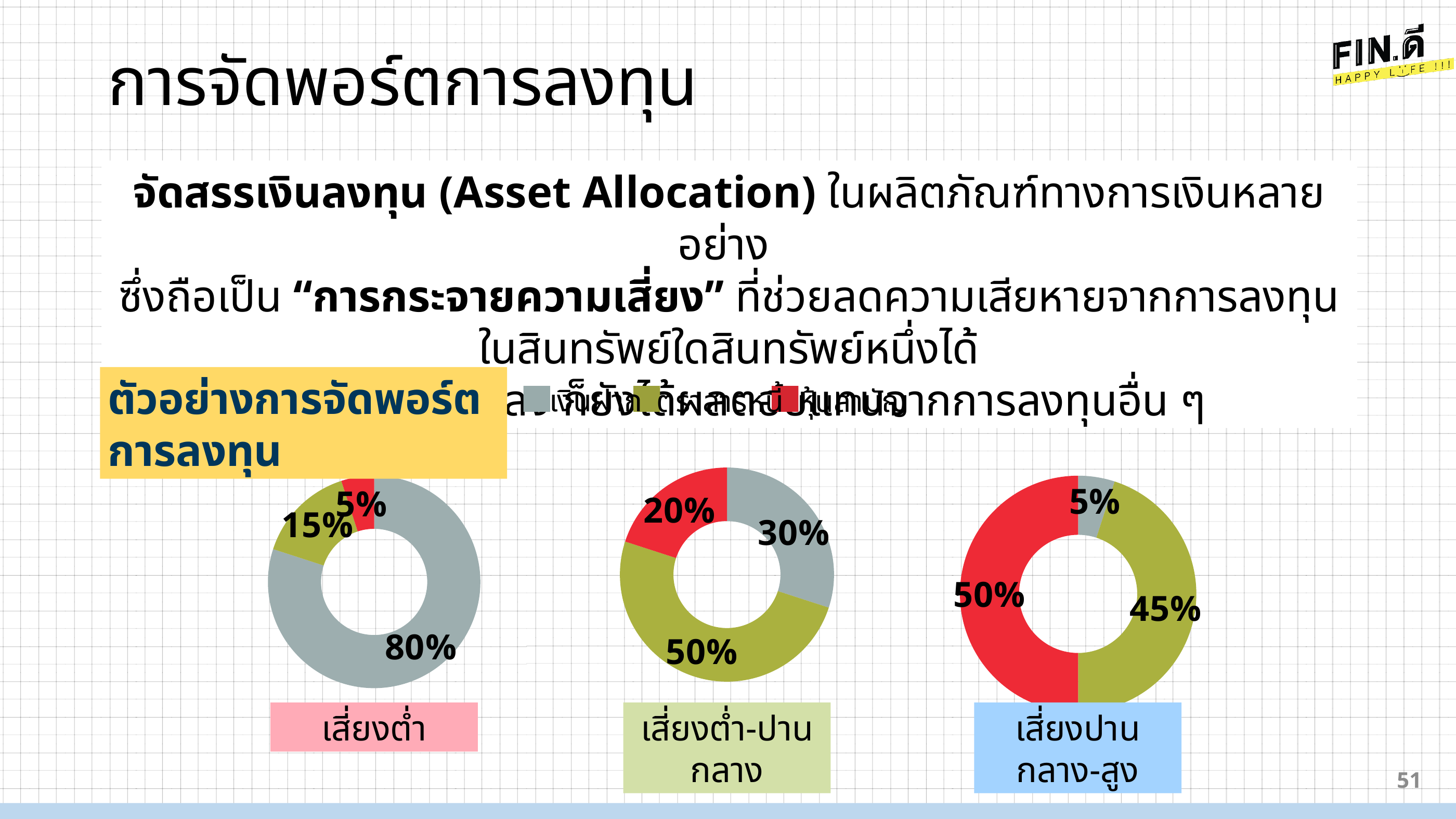
In the เสี่ยงปานกลาง-สูง chart, which colour slice is the smallest? grey In the เสี่ยงปานกลาง-สูง chart, which is larger, the red slice or the olive-green slice? red In the เสี่ยงต่ำ-ปานกลาง chart, what is the difference between the olive-green slice and the grey slice? 20% In the เสี่ยงปานกลาง-สูง chart, what share does the red slice have? 50% In the เสี่ยงต่ำ chart, what share does the grey slice have? 80% What kind of chart is the เสี่ยงต่ำ chart? donut chart In the เสี่ยงต่ำ-ปานกลาง chart, what share does the red slice have? 20% How many slices does the เสี่ยงต่ำ-ปานกลาง chart have? 3 In the เสี่ยงต่ำ-ปานกลาง chart, what share does the olive-green slice have? 50% In the เสี่ยงปานกลาง-สูง chart, what share does the grey slice have? 5% In the เสี่ยงต่ำ chart, what share does the red slice have? 5% In the เสี่ยงต่ำ chart, which colour slice is the largest? grey